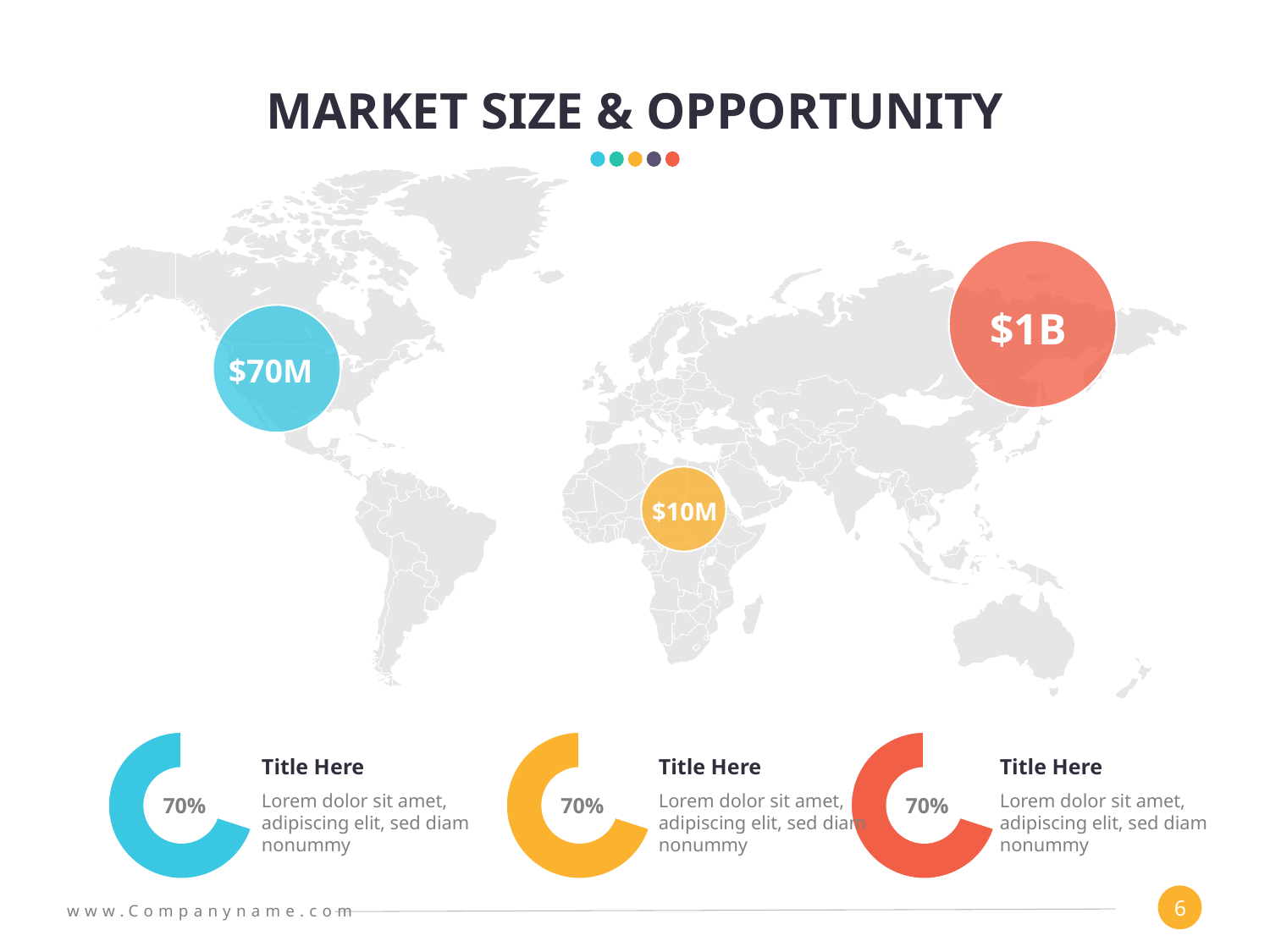
Which bubble on the map shows the smallest value? $10M What is the title of the slide? MARKET SIZE & OPPORTUNITY How many donut charts are shown at the bottom of the slide? 3 Which bubble on the map shows the largest value? $1B What percentage is shown in the leftmost donut chart at the bottom of the slide? 70% What percentage is shown in the rightmost donut chart at the bottom of the slide? 70% What value is shown in the red bubble over Asia on the map? $1B What value is shown in the yellow bubble over Africa on the map? $10M What kind of chart are the three small charts at the bottom of the slide? Donut charts Which is larger, the value in the blue bubble or the value in the yellow bubble? The blue bubble ($70M) How many value bubbles are placed on the world map? 3 What value is shown in the blue bubble over North America on the map? $70M